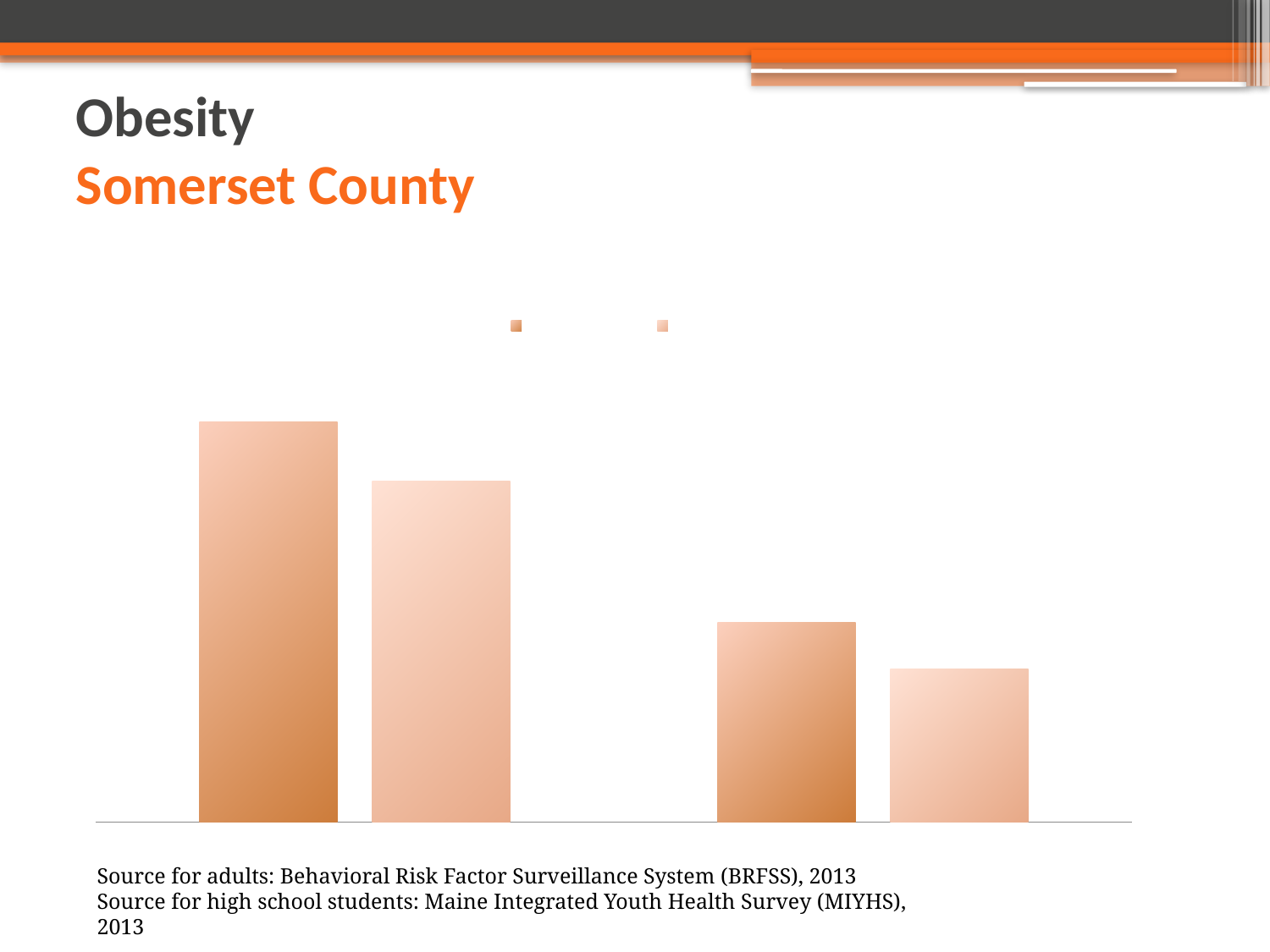
Which group of bars is taller, the left group or the right group? the left group Which bar in the chart is the shortest? the rightmost bar How many series does the legend above the chart show? 2 How many groups of bars are there in the chart? 2 Do the bar heights rise or fall from left to right across the chart? fall Within the right group of bars, is the darker orange bar or the lighter bar taller? the darker orange bar Within the left group of bars, is the darker orange bar or the lighter bar taller? the darker orange bar What is the title shown above the chart on the slide? Obesity Somerset County What kind of chart is shown on the slide? bar chart Which bar in the chart is the tallest? the leftmost bar What two colours are used for the bars in the chart? darker orange and lighter peach How many bars are plotted in the chart? 4